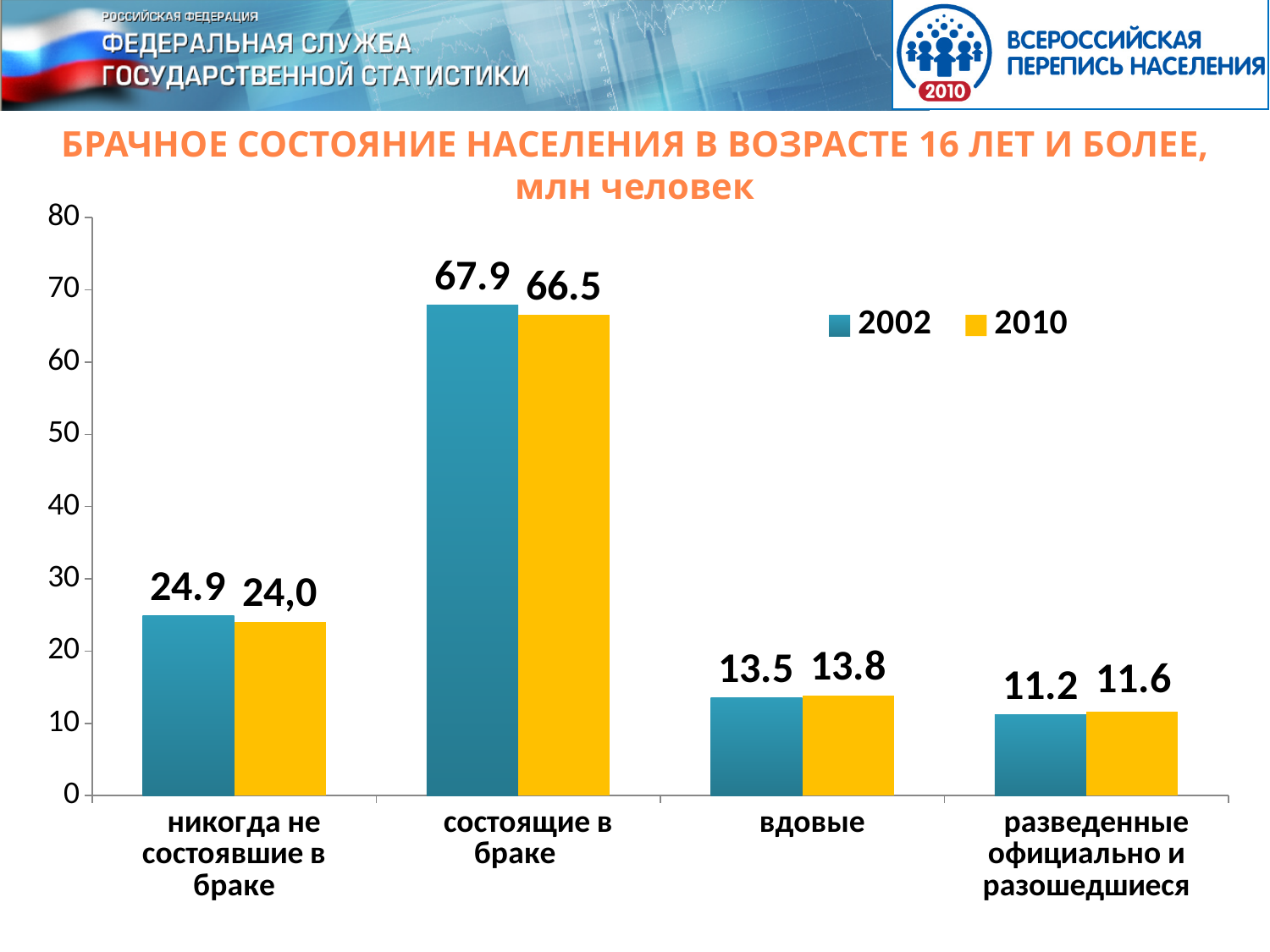
What is the value for "разведенные официально и разошедшиеся" in 2002? 11.2 What unit is stated in the chart title? млн человек What is the value for "никогда не состоявшие в браке" in 2010? 24,0 How many categories are shown on the x axis? 4 Which category has the lowest value in 2002? разведенные официально и разошедшиеся What kind of chart is shown on the slide? bar chart What is the difference between the 2002 and 2010 values for "состоящие в браке"? 1.4 Which is larger for "никогда не состоявшие в браке": the 2002 value or the 2010 value? 2002 How many series does the legend list? 2 What is the value for "состоящие в браке" in 2002? 67.9 What is the value for "вдовые" in 2010? 13.8 Which category has the highest value in 2010? состоящие в браке